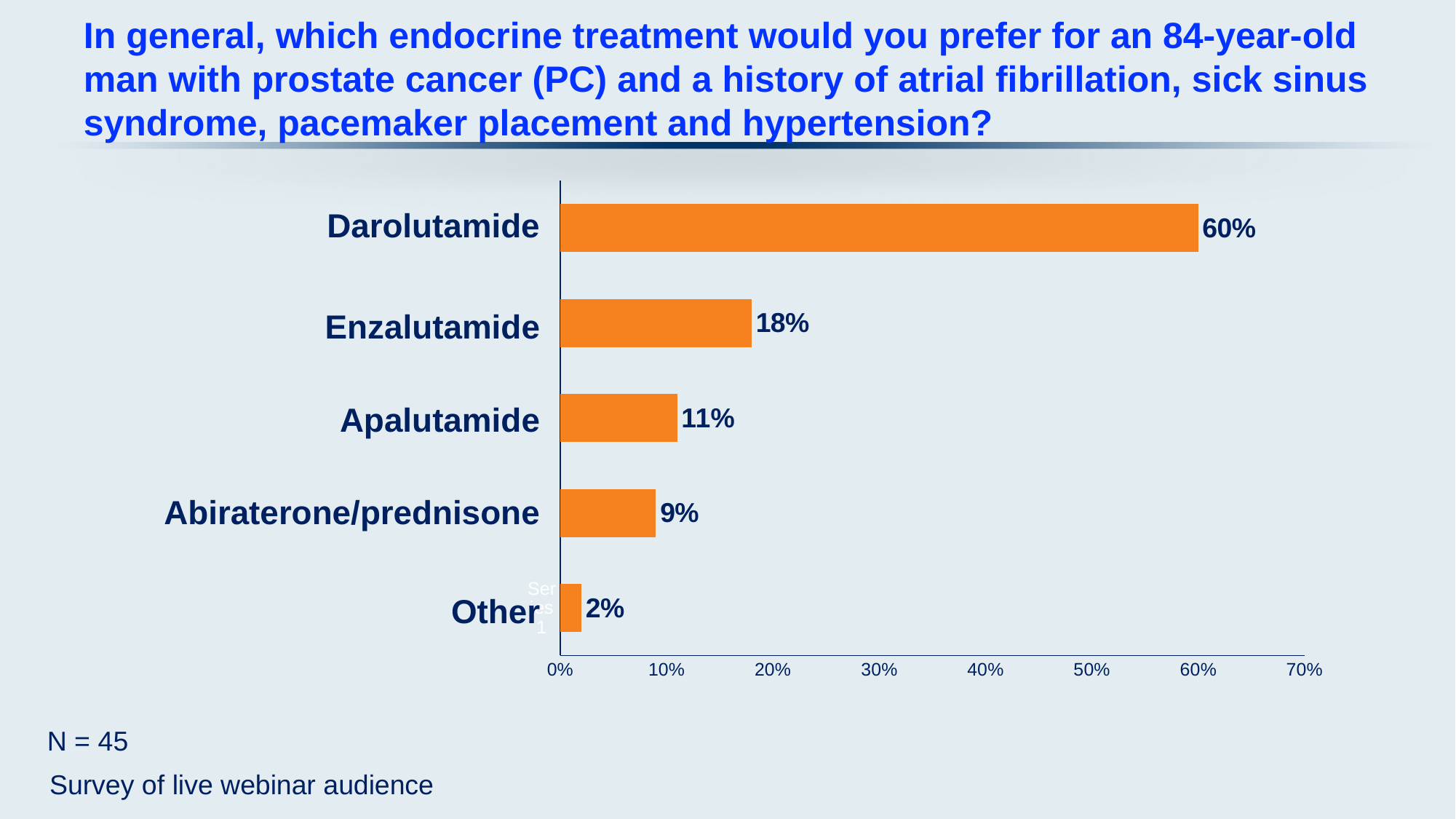
What is the sample size (N) stated on the slide? 45 What is the difference in percentage points between Darolutamide and Enzalutamide? 42 How many treatment options are shown in the chart? 5 What percentage of respondents chose Other? 2% Which received a larger share of responses, Apalutamide or Abiraterone/prednisone? Apalutamide What percentage of respondents preferred Darolutamide? 60% What percentage of respondents preferred Apalutamide? 11% Which treatment option received the highest share of responses? Darolutamide What kind of chart is shown on the slide? Bar chart What percentage of respondents preferred Enzalutamide? 18% Which option received the lowest share of responses? Other What percentage of respondents chose Abiraterone/prednisone? 9%